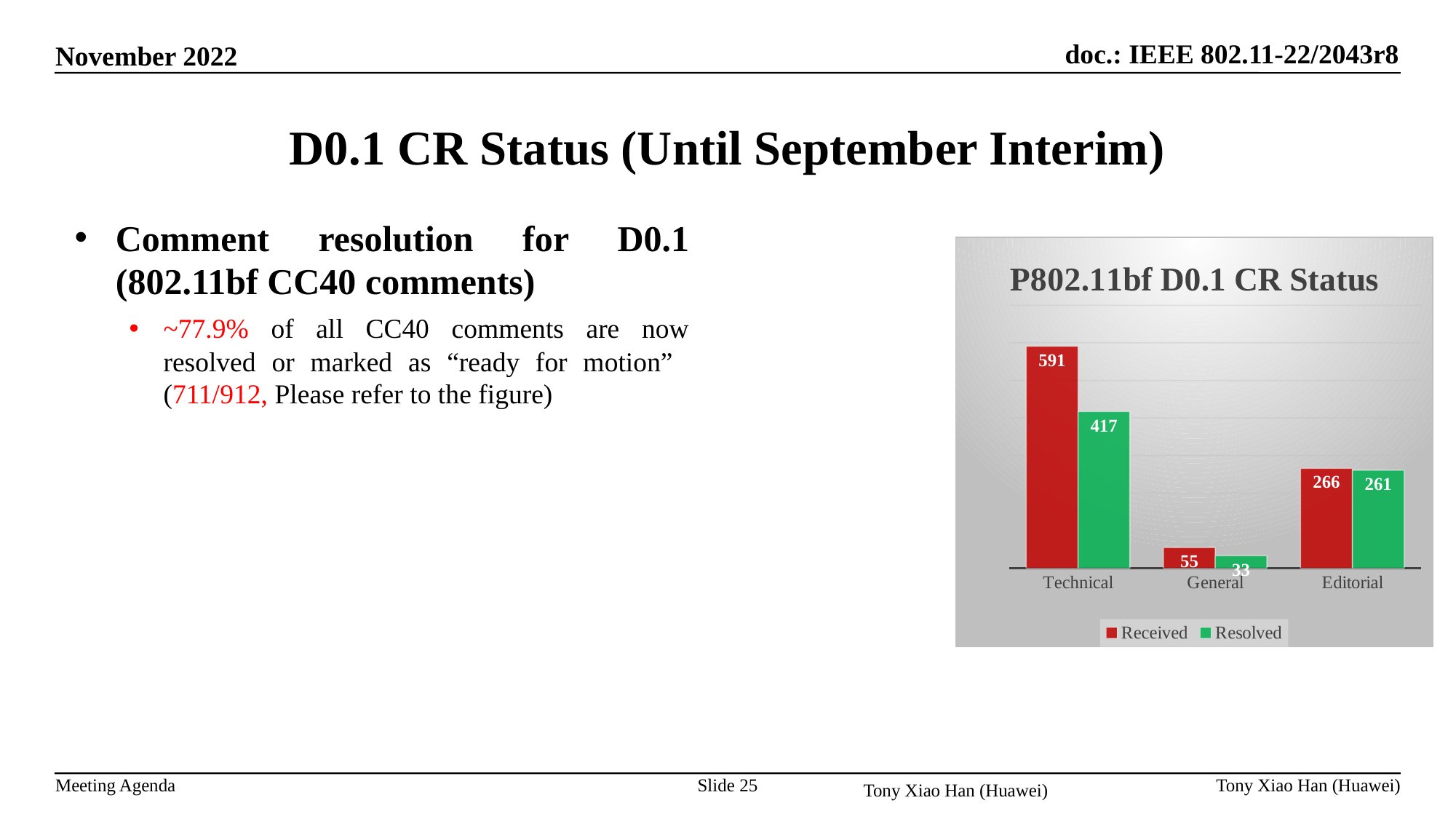
What is the difference between Received and Resolved for Technical? 174 What is the Received value for Technical? 591 How many series does the legend list? 2 How many categories are shown on the x axis? 3 What is the Received value for General? 55 What is the Resolved value for Editorial? 261 Which is larger, the Resolved value for Technical or the Received value for Editorial? Resolved value for Technical Which category has the lowest Resolved value? General What type of chart is shown? Bar chart What is the difference between Received and Resolved for Editorial? 5 Which category has the highest Received value? Technical What is the Resolved value for General? 33